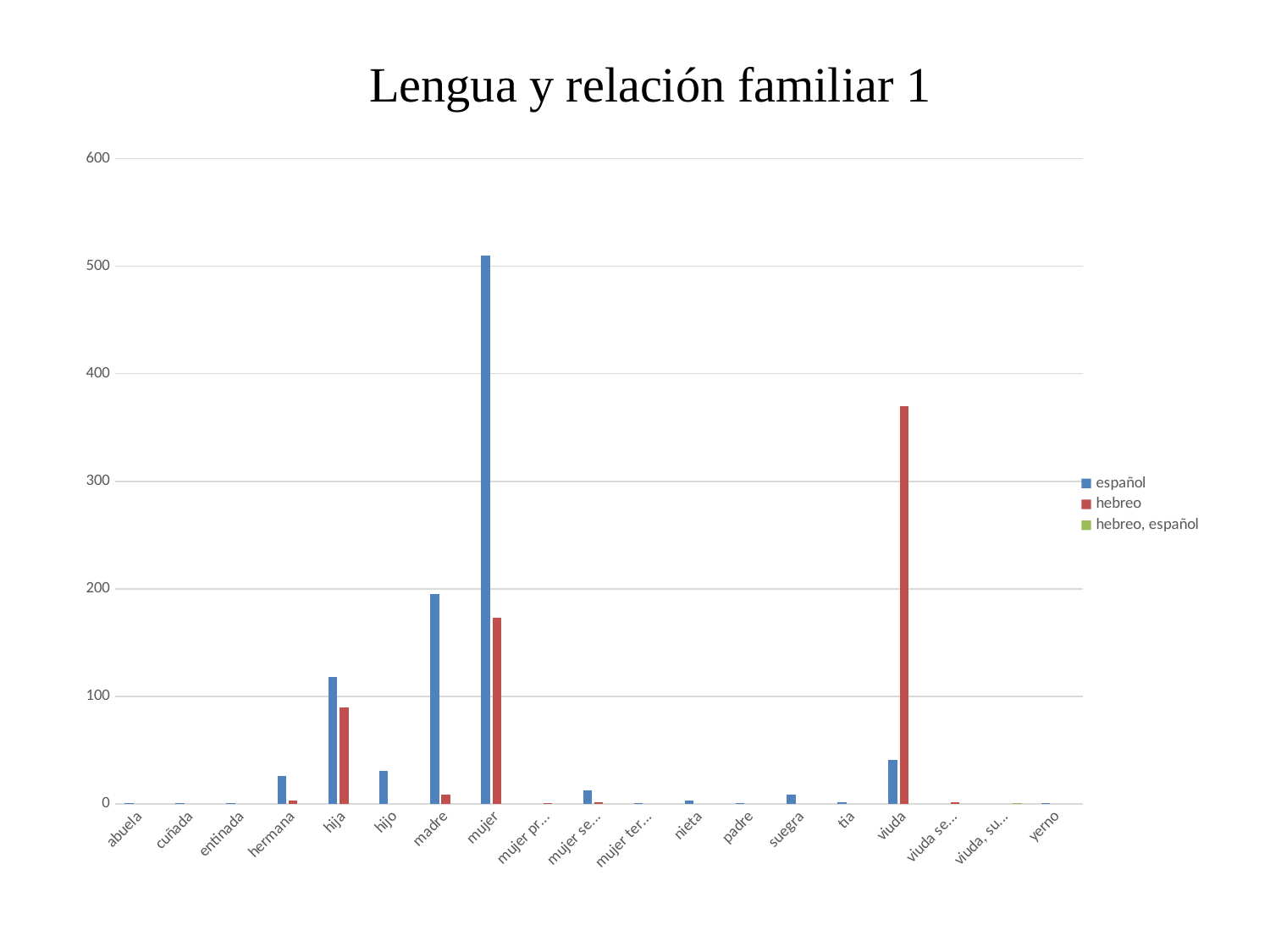
What is the title of the chart? Lengua y relación familiar 1 Which category has the highest value for the hebreo series? viuda What kind of chart is shown on the slide? bar chart Is the español value for madre greater or less than 100? greater Is the hebreo value for hija greater or less than 100? less For the category madre, which series has the larger value, español or hebreo? español Is the hebreo value for viuda greater or less than 400? less How many categories are shown along the x axis? 19 Which category has the highest value for the español series? mujer How many series does the legend list? 3 For the category viuda, which series has the larger value, español or hebreo? hebreo